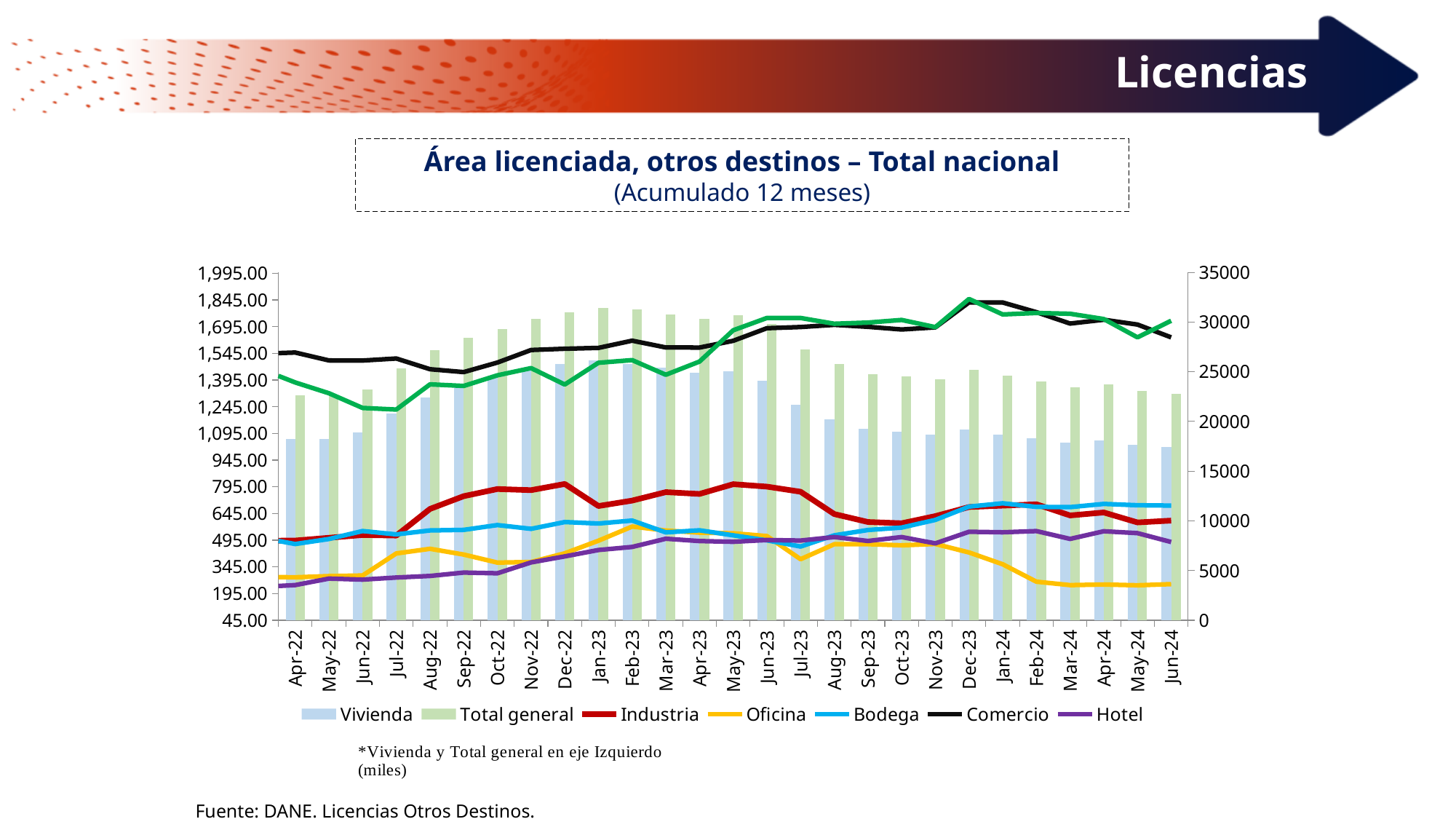
Is the Industria value for Dec-22 greater or less than 10000 on the right axis? greater Is the Comercio value for Dec-23 greater or less than 30000 on the right axis? greater What kind of chart is shown on the slide? A combination bar and line chart How many series does the legend list? 7 Is the Total general bar for Jan-23 greater or less than 1,695.00 on the left axis? greater In Jun-24, which series has the larger value: Hotel or Oficina? Hotel How many months are shown along the x axis? 27 In Apr-22, which series has the larger value: Comercio or Industria? Comercio According to the note below the chart, which two series are plotted on the left axis? Vivienda and Total general Does the Oficina line rise or fall from Jan-24 to Jun-24? fall